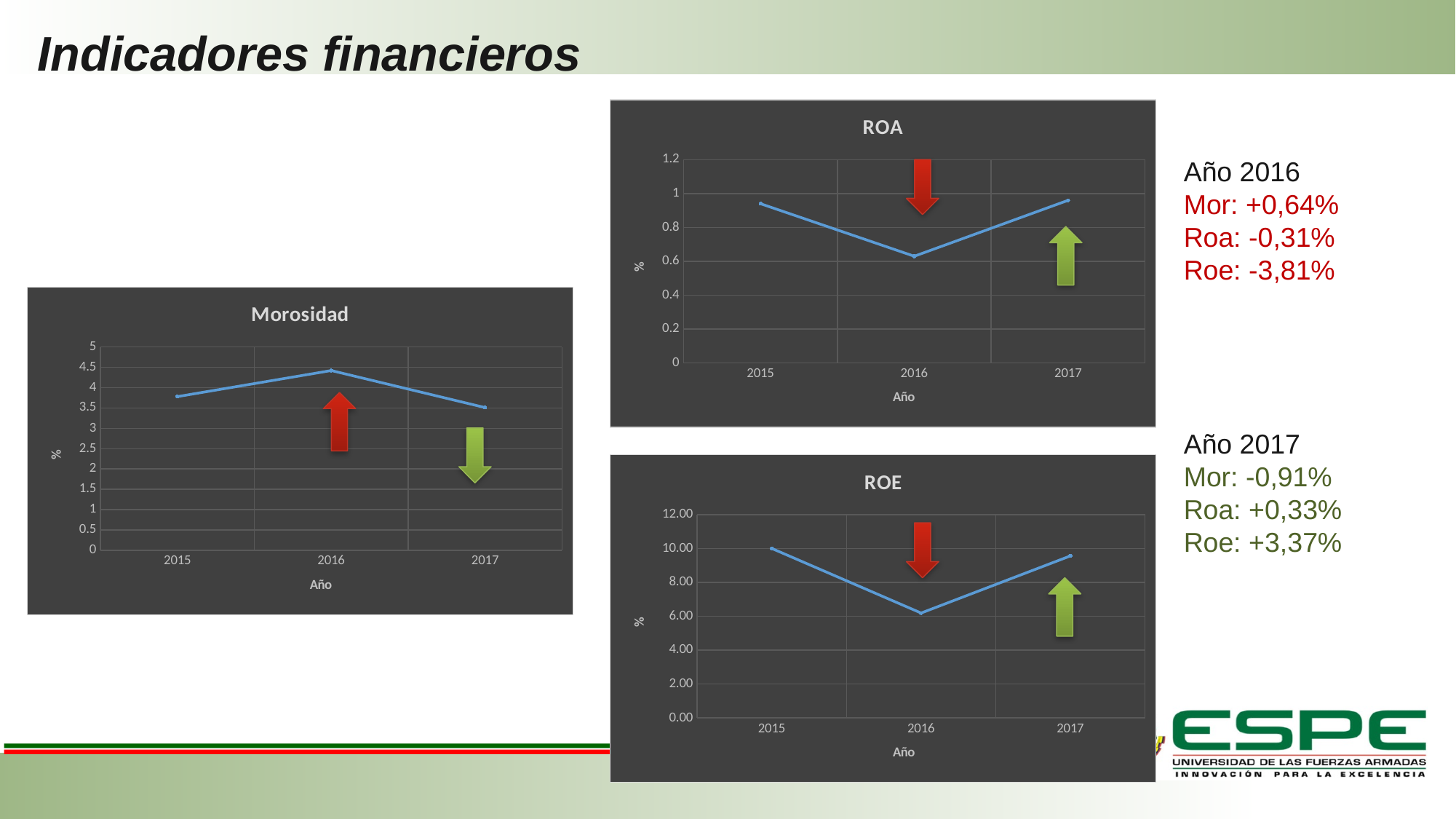
In the ROE chart, is the value for 2016 greater or less than 8.00? less What is the label on the y axis of the ROA chart? % In the ROE chart, which year has the lowest value? 2016 In the ROA chart, which is larger, the value for 2015 or the value for 2016? 2015 How many years are plotted on the x axis of the ROA chart? 3 What kind of chart is the Morosidad chart? line chart In the ROE chart, does the value rise or fall from 2016 to 2017? rise In the Morosidad chart, is the value for 2016 greater or less than 4? greater In the Morosidad chart, which year has the highest value? 2016 In the ROA chart, which year has the lowest value? 2016 In the ROA chart, is the value for 2016 greater or less than 0.8? less